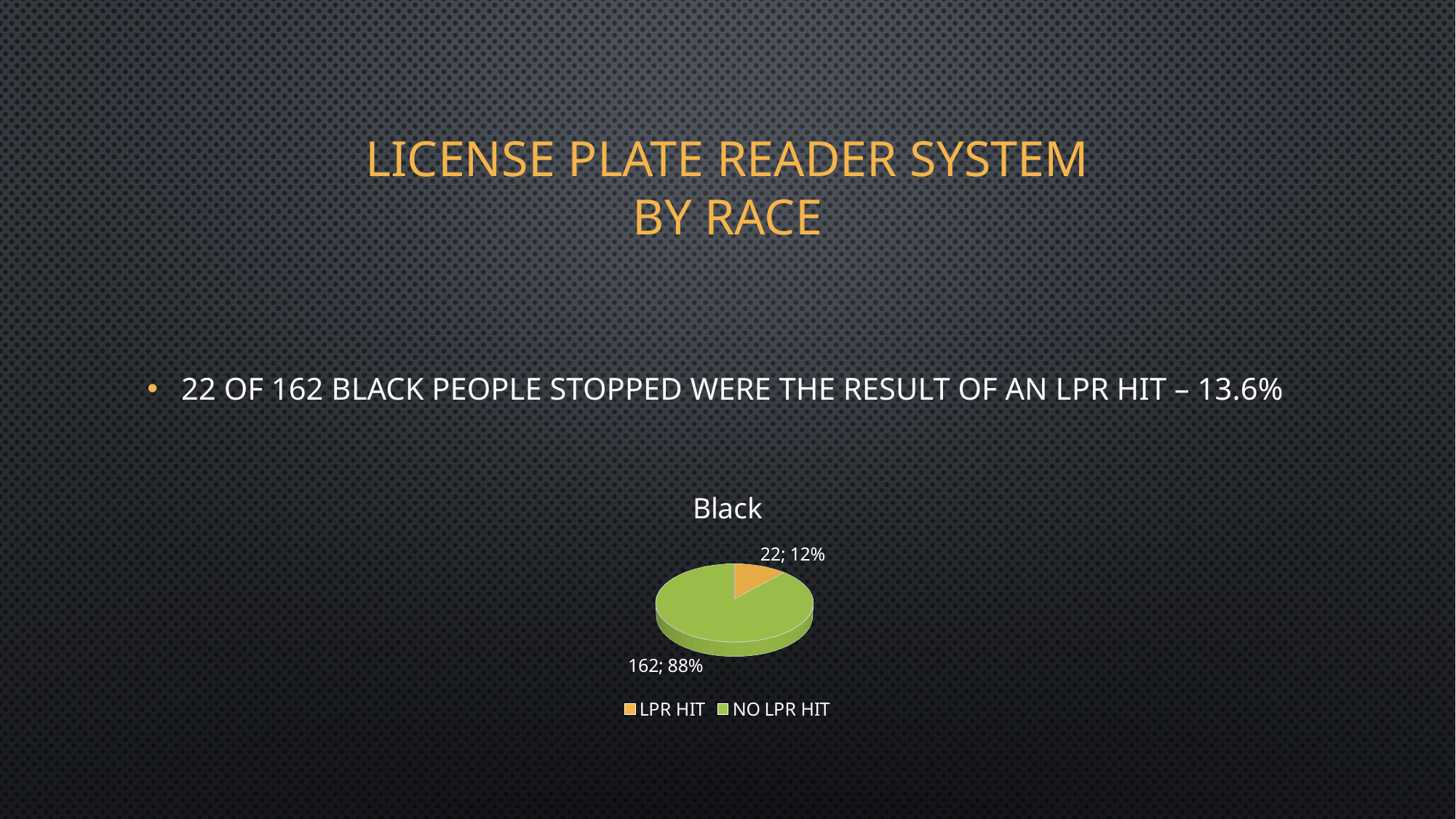
What is the value for NO LPR HIT in the pie chart? 162 What share of the pie does NO LPR HIT represent? 88% What colour is the LPR HIT slice? Orange Which slice is the smallest in the pie chart? LPR HIT Which slice is the largest in the pie chart? NO LPR HIT What is the difference between the NO LPR HIT value and the LPR HIT value? 140 What is the title of the chart? Black Which is larger, LPR HIT or NO LPR HIT? NO LPR HIT What type of chart is shown on the slide? Pie chart What share of the pie does LPR HIT represent? 12% What is the value for LPR HIT in the pie chart? 22 How many slices does the pie chart have? 2